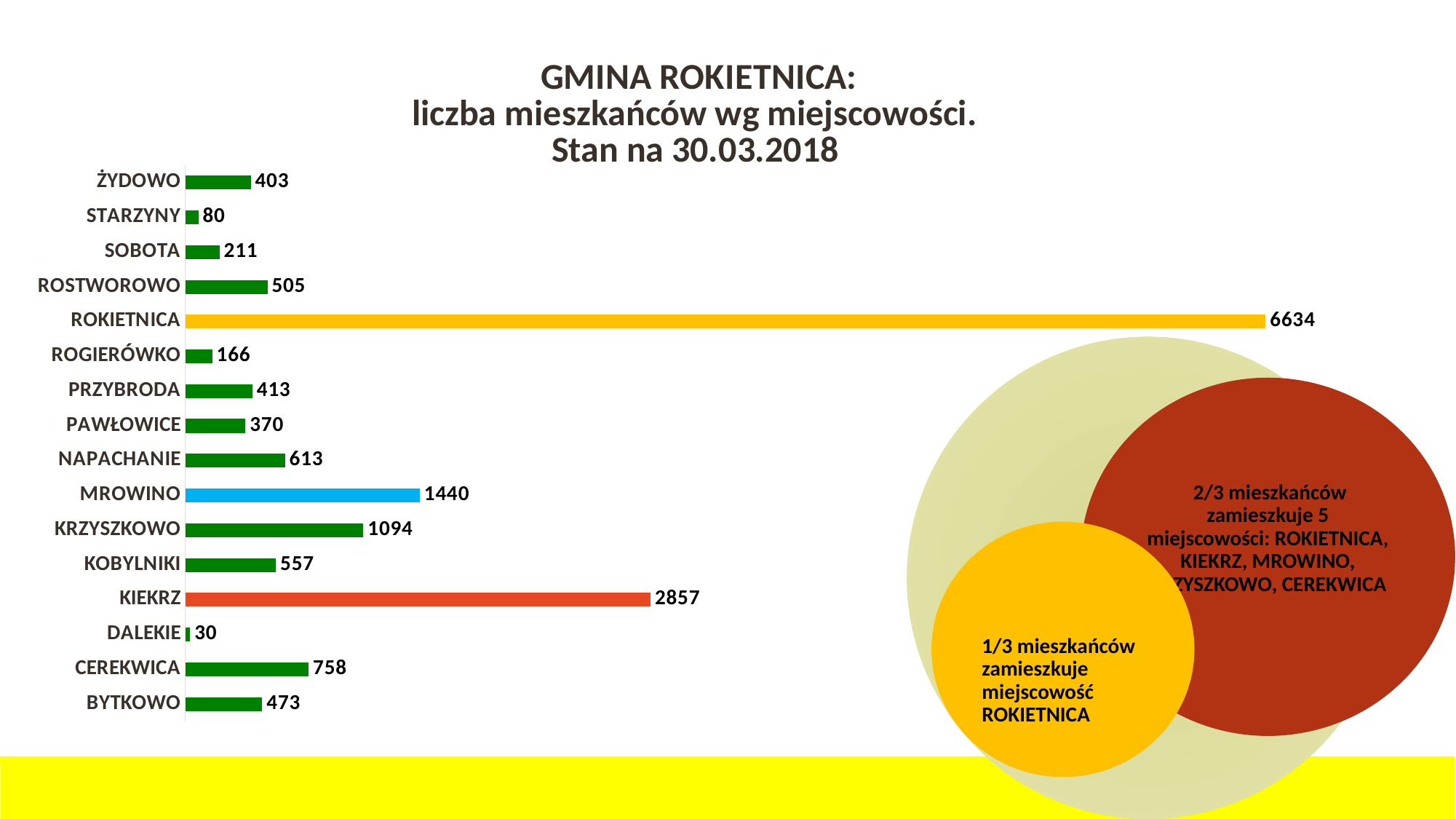
What value is shown for CEREKWICA? 758 How many localities are shown in the bar chart? 16 Which locality has the lowest number of inhabitants? DALEKIE What value is shown for MROWINO? 1440 What is the number of inhabitants shown for ROKIETNICA? 6634 What colour is the bar for ROKIETNICA? Yellow What is the difference between the values for KRZYSZKOWO and CEREKWICA? 336 Which locality has the highest number of inhabitants? ROKIETNICA What value is shown for KIEKRZ? 2857 What is the difference between the values for KIEKRZ and MROWINO? 1417 Which has more inhabitants, NAPACHANIE or KOBYLNIKI? NAPACHANIE What type of chart is used to show the number of inhabitants by locality? Bar chart